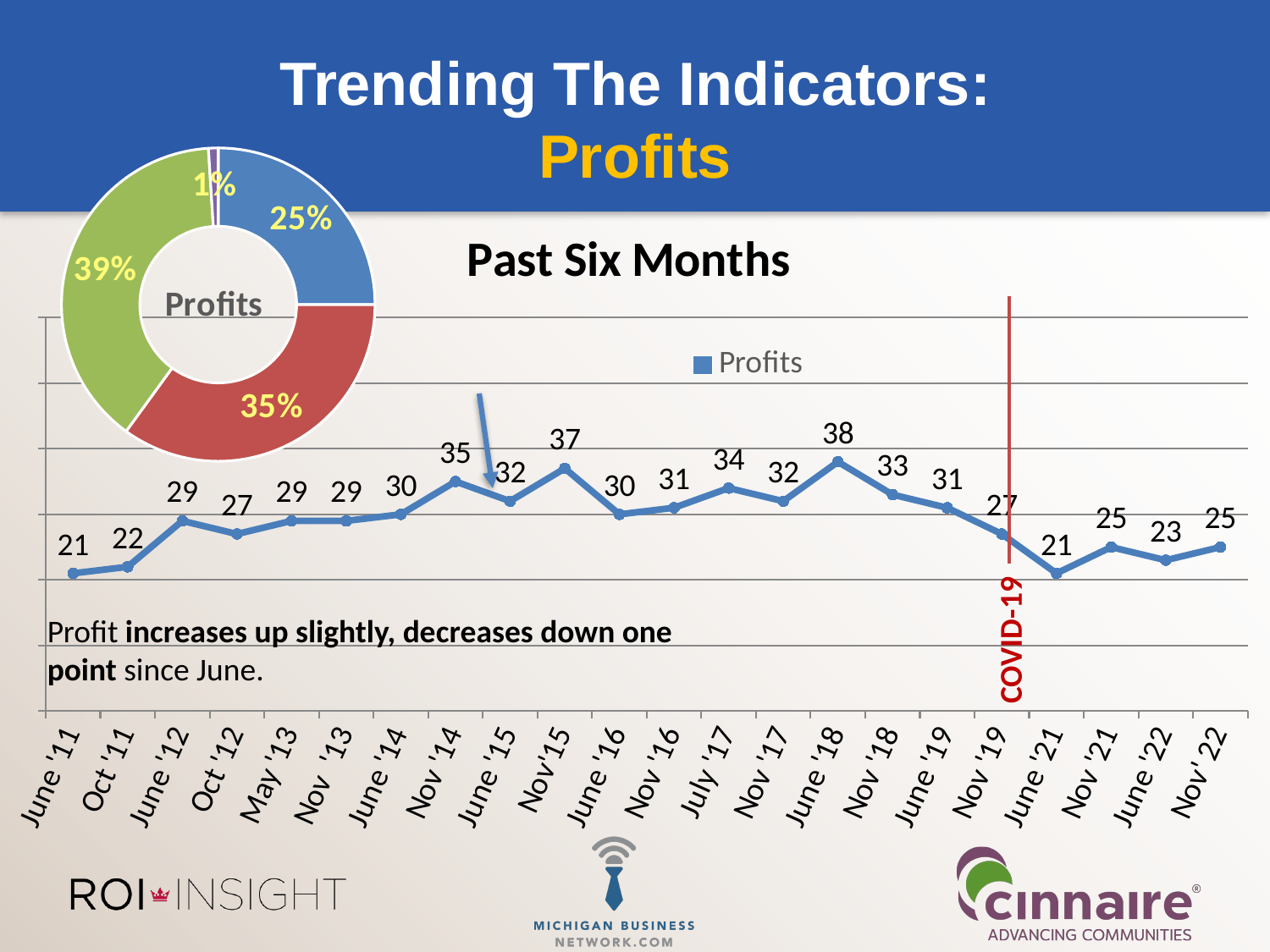
In the line chart, what is the difference between the Profits values for Nov '15 and June '16? 7 In the line chart, what is the Profits value for Nov '22? 25 In the line chart, how many data points are plotted? 22 In the line chart, do the Profits values rise or fall from June '18 to June '21? fall In the line chart, what is the Profits value for June '11? 21 In the line chart, how many series does the legend list? 1 In the line chart, what is the Profits value for June '18? 38 What kind of chart is the chart titled 'Past Six Months'? line chart In the line chart, which is larger, the Profits value for Nov '14 or for June '15? Nov '14 In the donut chart labelled 'Profits', what share does the red slice represent? 35% In the line chart, which period has the highest Profits value? June '18 In the donut chart labelled 'Profits', what is the largest slice's share? 39%